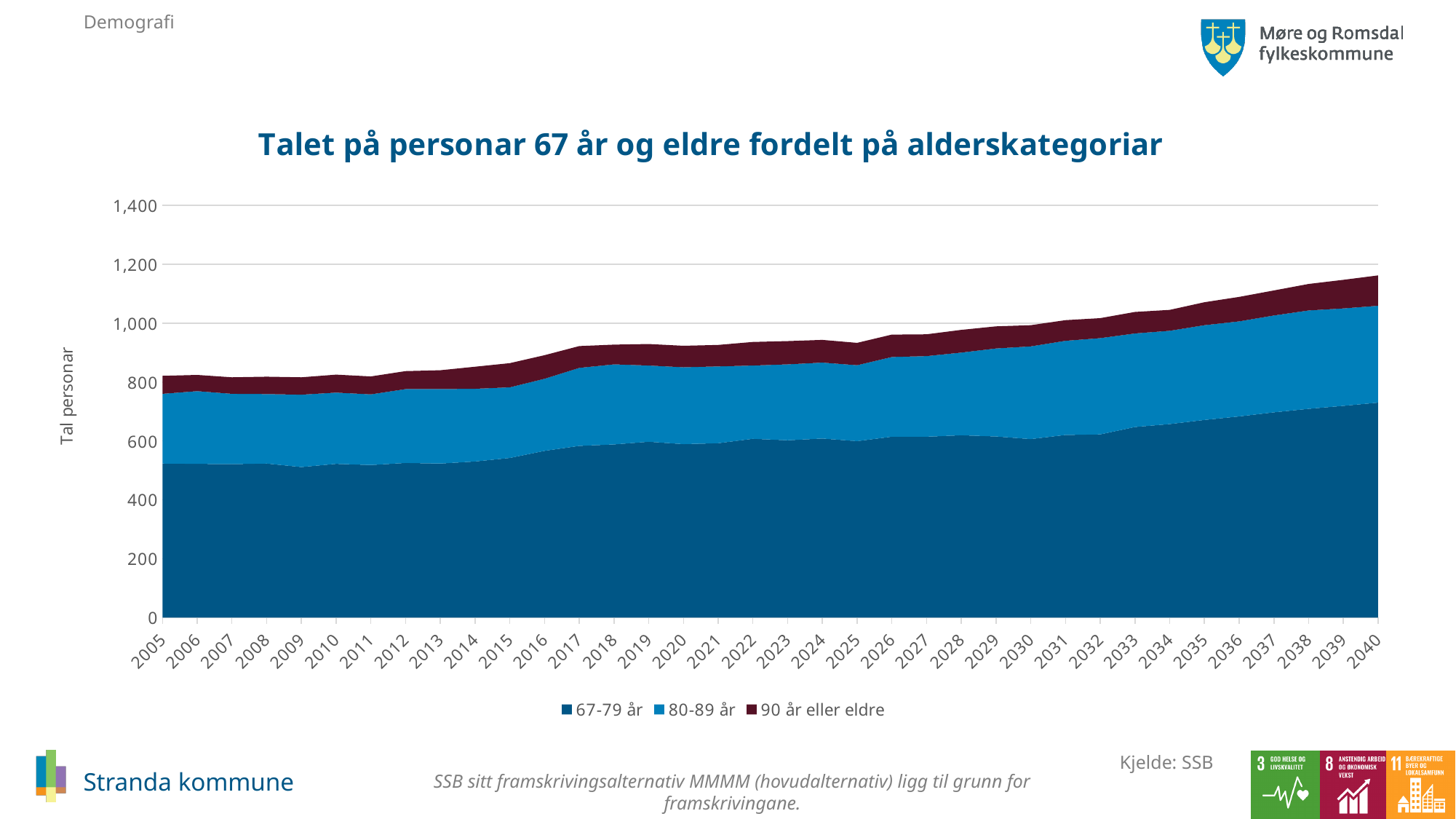
What kind of chart is shown on the slide? Stacked area chart Does the total number of persons 67 years and older rise or fall from 2005 to 2040? Rise Is the value for 67-79 år in 2005 greater or less than 600? less In 2040, which is larger: the 67-79 år series or the 80-89 år series? 67-79 år Is the total value for 2005 greater or less than 1,000? less Is the total value for 2040 greater or less than 1,000? greater How many series does the legend list? 3 How many years are plotted along the x axis? 36 What is the title of the chart? Talet på personar 67 år og eldre fordelt på alderskategoriar What is the label on the y axis? Tal personar Which age category contributes the smallest share of the total in 2040? 90 år eller eldre